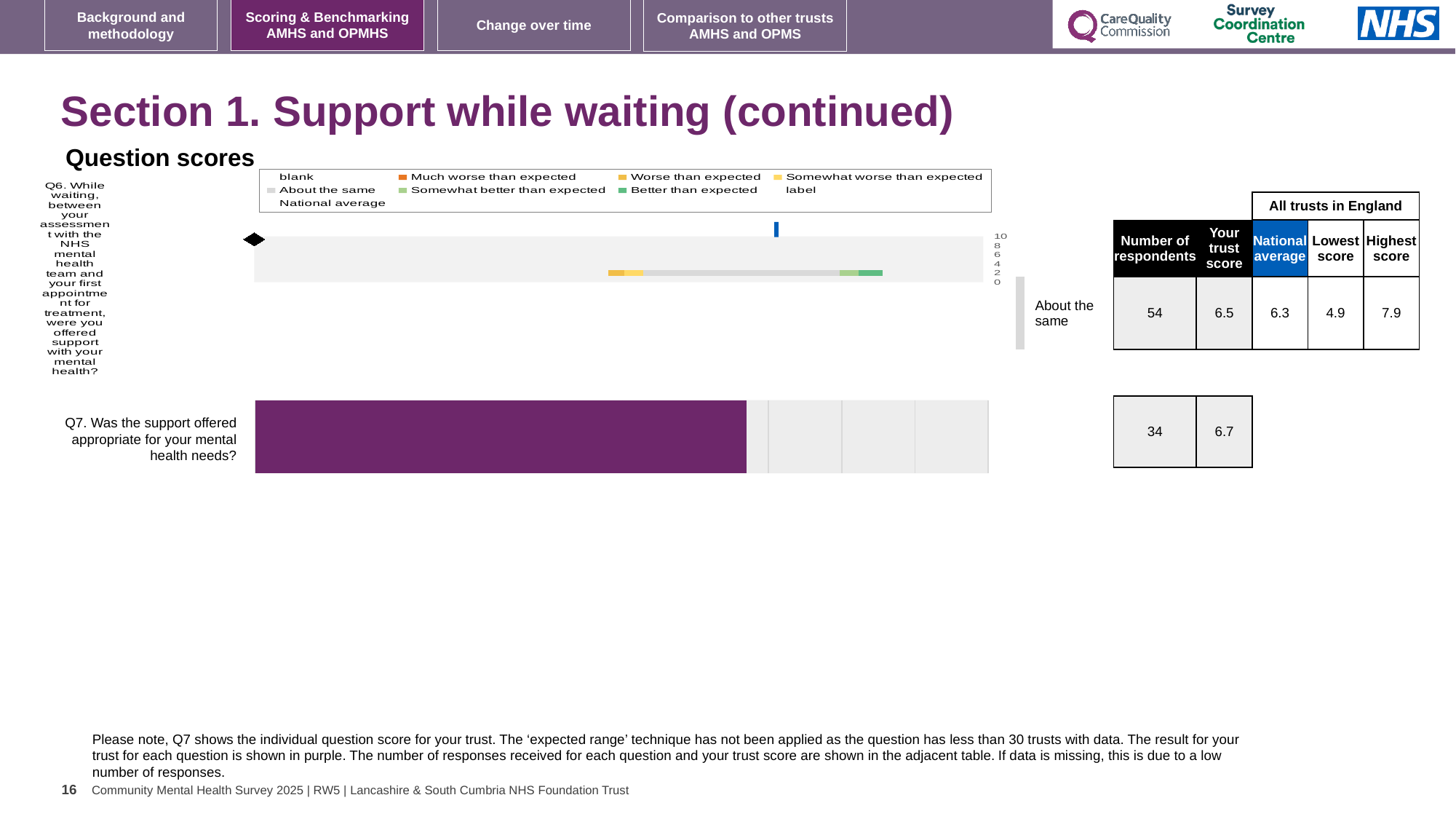
Is the trust score for Q6 higher or lower than the national average? higher What is the trust score for Q6 shown in the table next to the chart? 6.5 What is the difference between the highest and lowest scores for Q6 across all trusts in England? 3.0 How many respondents answered Q6? 54 What colour is the bar showing the Q7 trust score? Purple What is the national average score for Q6? 6.3 What is the trust score for Q7? 6.7 How many respondents answered Q7? 34 What is the lowest score among all trusts in England for Q6? 4.9 What is the highest score among all trusts in England for Q6? 7.9 Is the Q7 purple bar greater or less than 6 on the 0 to 10 scale? greater Which expected-range category is the Q6 trust score labelled as? About the same